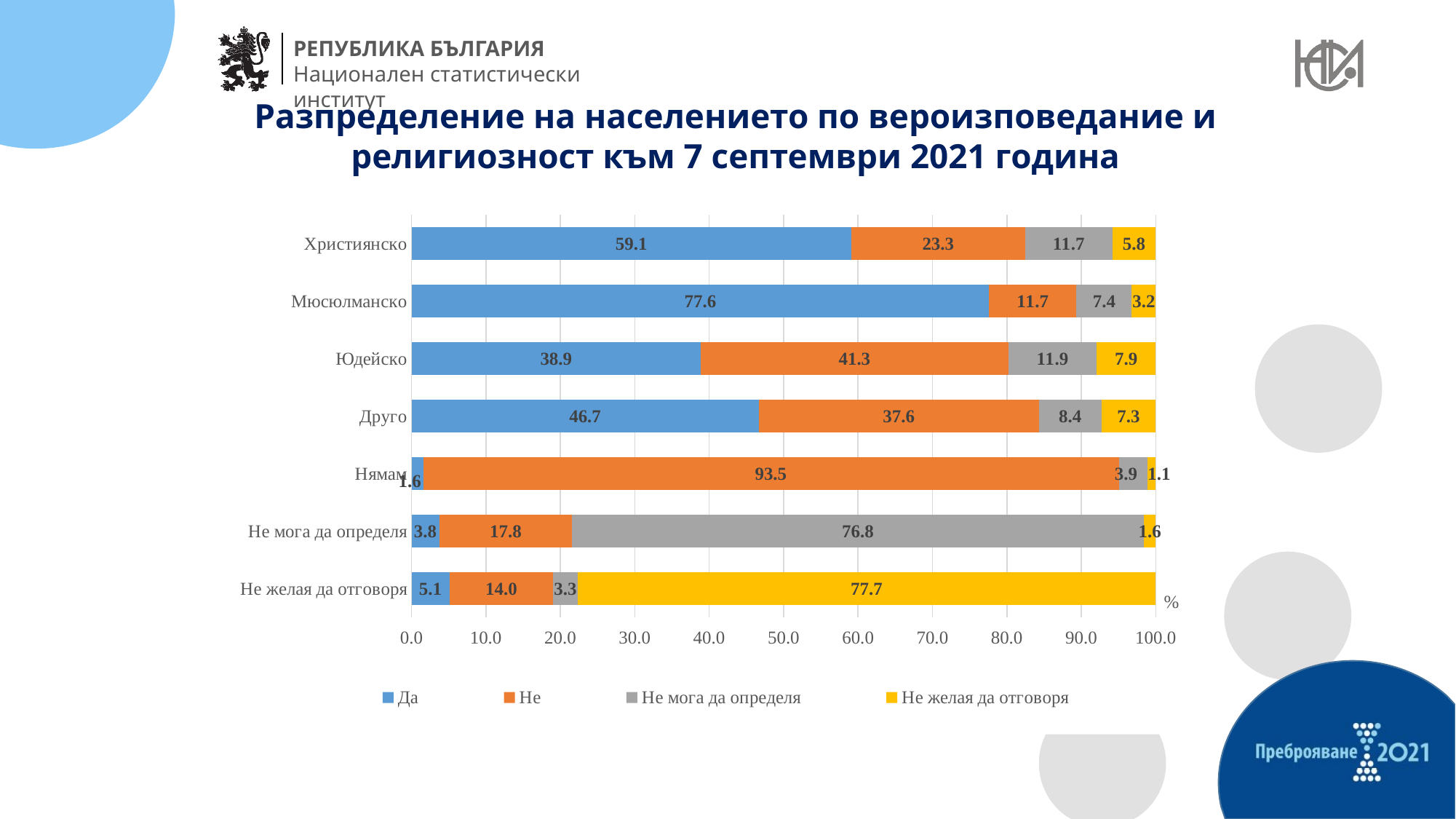
What is the value of the "Не" series for "Юдейско"? 41.3 What kind of chart is shown on the slide? Stacked bar chart Which category has the highest value in the "Да" series? Мюсюлманско Which category has the lowest value in the "Да" series? Нямам What is the value of the "Не мога да определя" series for the "Не мога да определя" category? 76.8 How many series does the legend list? 4 What is the value of the "Да" series for "Християнско"? 59.1 What is the difference between the "Не" values for "Християнско" and "Мюсюлманско"? 11.6 Which has a larger "Да" value, "Юдейско" or "Друго"? Друго How many categories are shown on the vertical axis of the chart? 7 What is the value of the "Не желая да отговоря" series for the "Не желая да отговоря" category? 77.7 Which category has the highest value in the "Не" series? Нямам